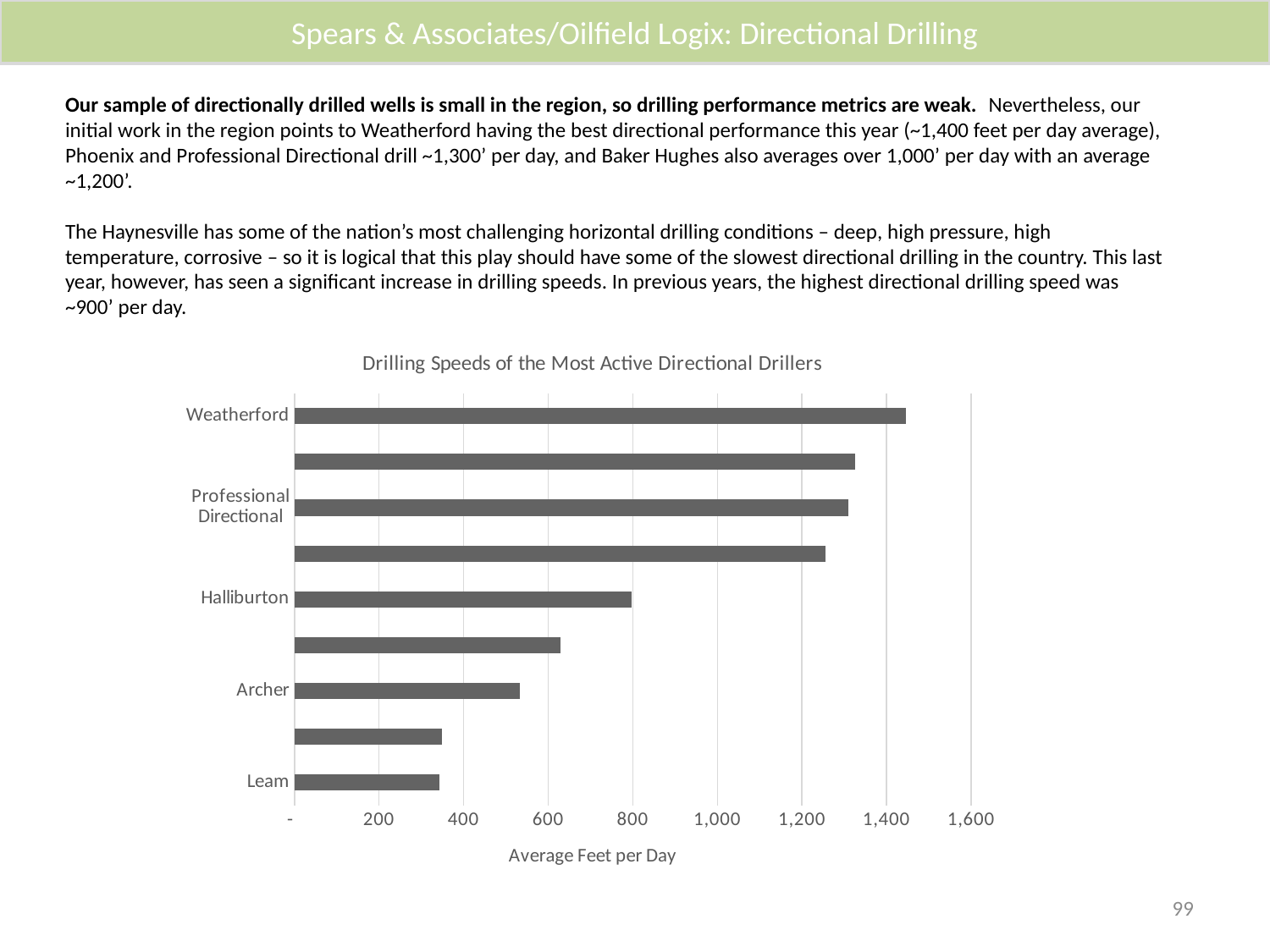
Which driller has the highest average feet per day in the chart? Weatherford Which has a higher average feet per day, Halliburton or Professional Directional? Professional Directional Is the value for Archer greater or less than 600? less Which has a higher average feet per day, Archer or Leam? Archer What is the title of the horizontal axis of the chart? Average Feet per Day Is the value for Leam greater or less than 400? less Is the value for Halliburton greater or less than 600? greater What is the title of the chart? Drilling Speeds of the Most Active Directional Drillers How many bars are plotted in the chart? 9 What kind of chart is shown on the slide? bar chart